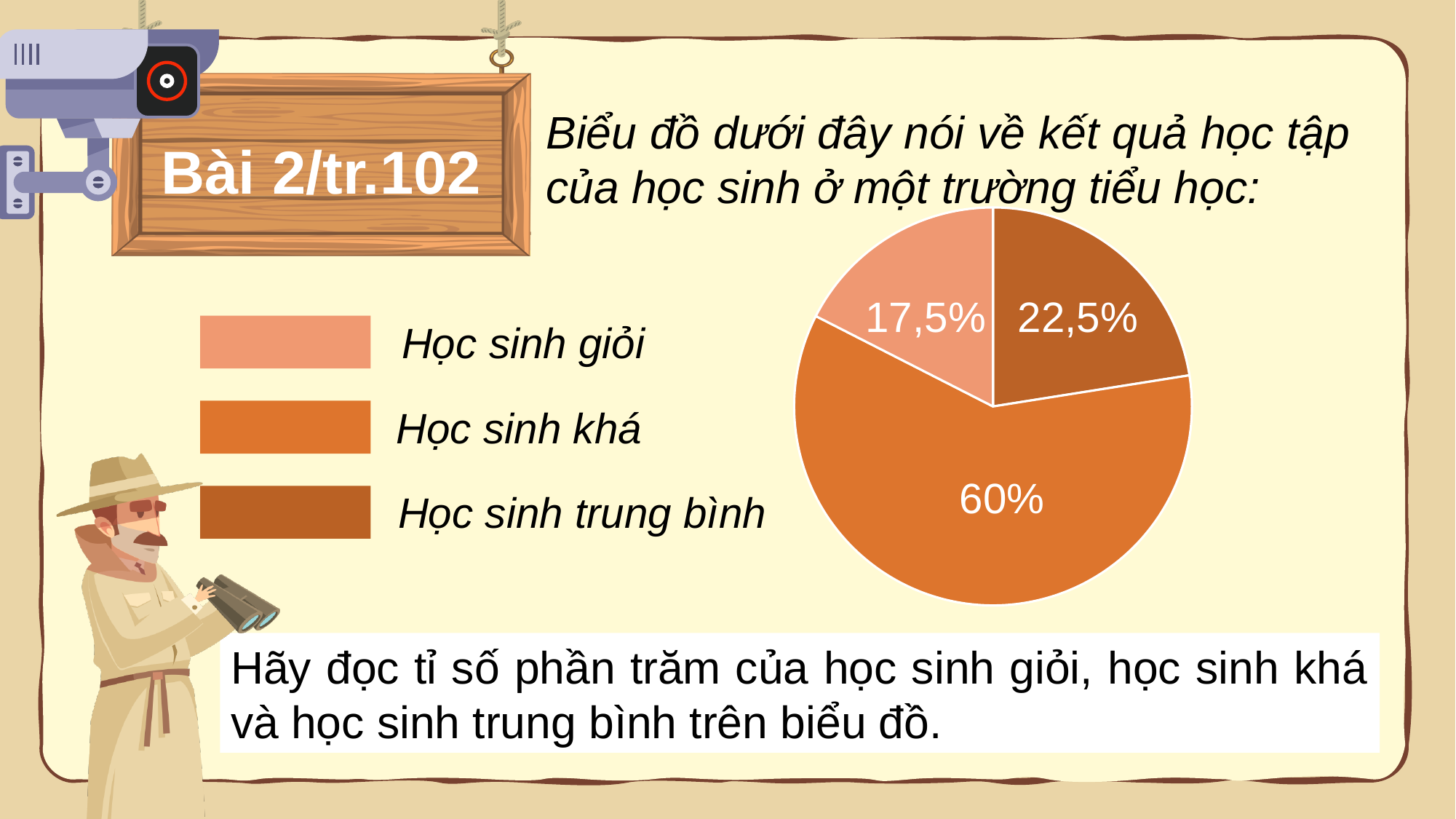
What percentage of the pie chart is for Học sinh giỏi? 17,5% Which category has the smallest slice of the pie chart? Học sinh giỏi What percentage of the pie chart is for Học sinh khá? 60% What kind of chart is shown on the slide? pie chart How many entries does the legend list? 3 How many slices does the pie chart have? 3 What is the difference between the percentages for Học sinh khá and Học sinh trung bình? 37,5% Which category has the largest slice of the pie chart? Học sinh khá What is the difference between the percentages for Học sinh trung bình and Học sinh giỏi? 5% Which legend entry is shown with the lightest colour? Học sinh giỏi Which is larger, the slice for Học sinh giỏi or the slice for Học sinh trung bình? Học sinh trung bình What percentage of the pie chart is for Học sinh trung bình? 22,5%